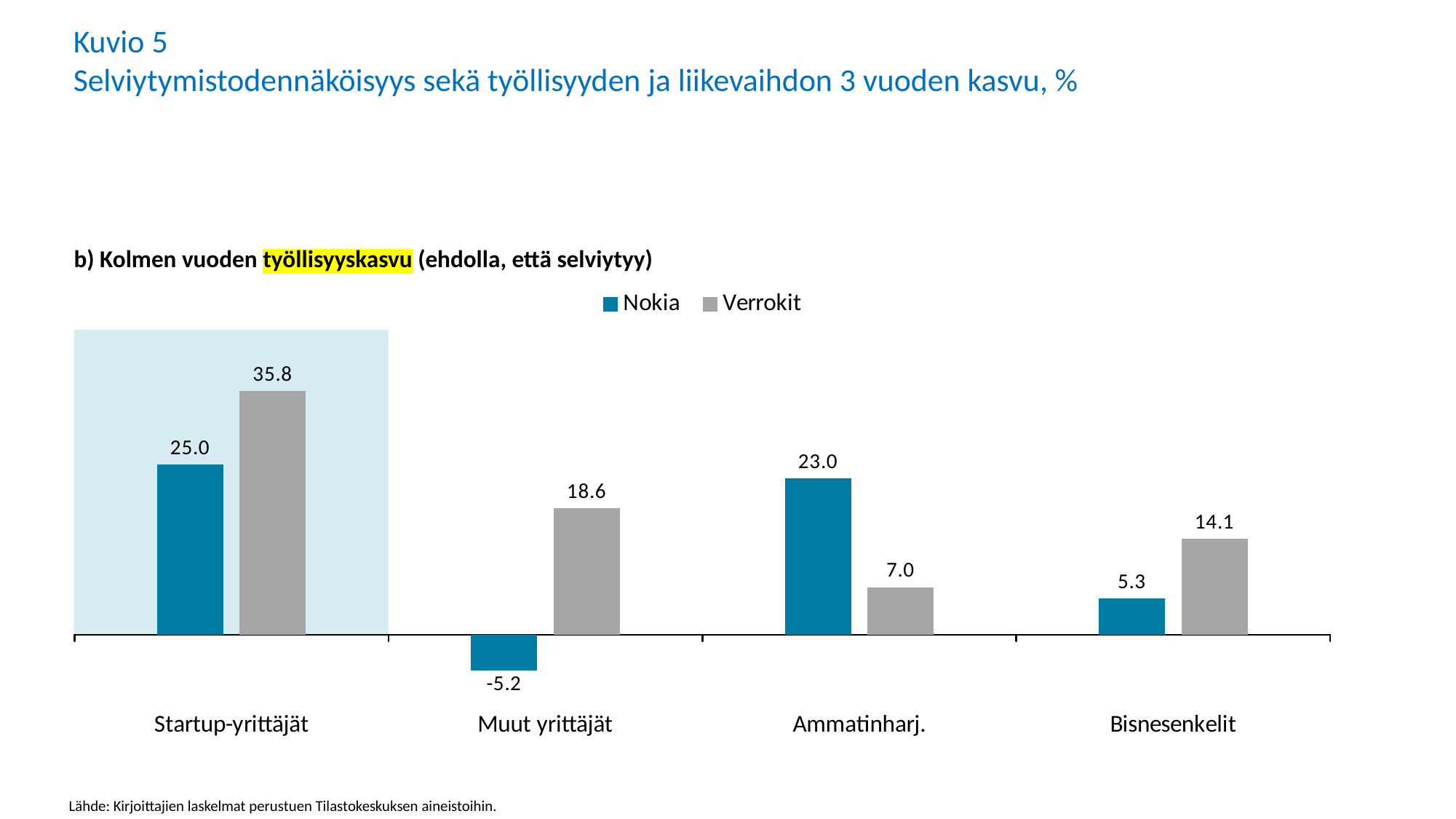
What kind of chart is this? Bar chart What is the Verrokit value for Bisnesenkelit? 14.1 What is the Nokia value for Startup-yrittäjät? 25.0 How many series does the legend list? 2 Which category has the highest Verrokit value? Startup-yrittäjät What is the Nokia value for Muut yrittäjät? -5.2 For Ammatinharj., which series has the larger value, Nokia or Verrokit? Nokia Which category has the lowest Nokia value? Muut yrittäjät Which series is shown in grey in the legend? Verrokit How many categories are shown on the x axis? 4 What is the difference between the Verrokit and Nokia values for Startup-yrittäjät? 10.8 What is the Verrokit value for Muut yrittäjät? 18.6